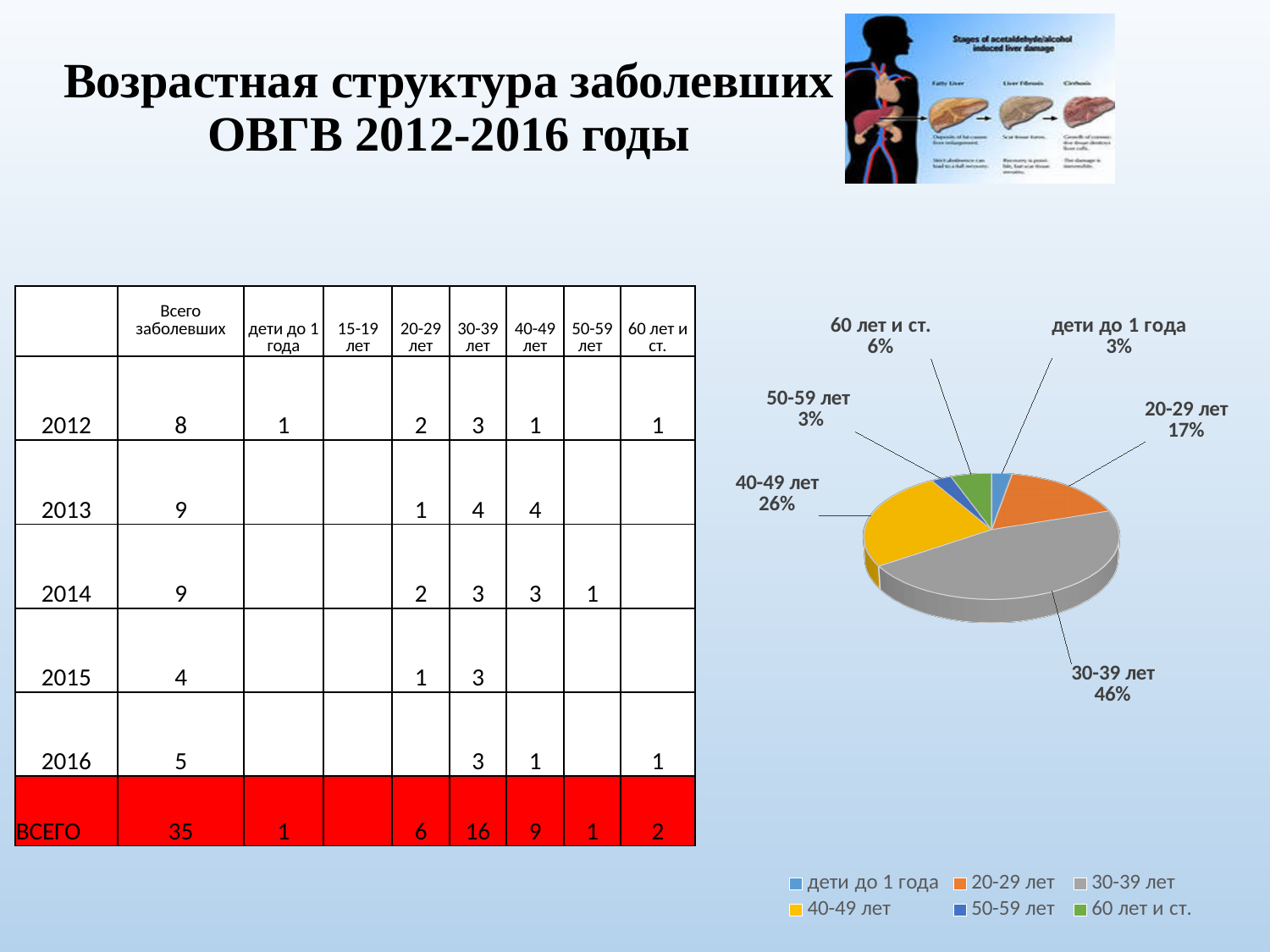
In the pie chart, what share is shown for the 20-29 лет slice? 17% In the pie chart, what share is shown for the 30-39 лет slice? 46% Which slice is larger in the pie chart: 40-49 лет or 20-29 лет? 40-49 лет How many entries does the legend of the pie chart list? 6 In the pie chart, what share is shown for the 40-49 лет slice? 26% What kind of chart is shown on the right side of the slide? pie chart What colour is the 30-39 лет slice in the pie chart? grey How many slices does the pie chart have? 6 What is the difference in percentage points between the 30-39 лет slice and the 40-49 лет slice in the pie chart? 20 Which age group has the largest slice in the pie chart? 30-39 лет